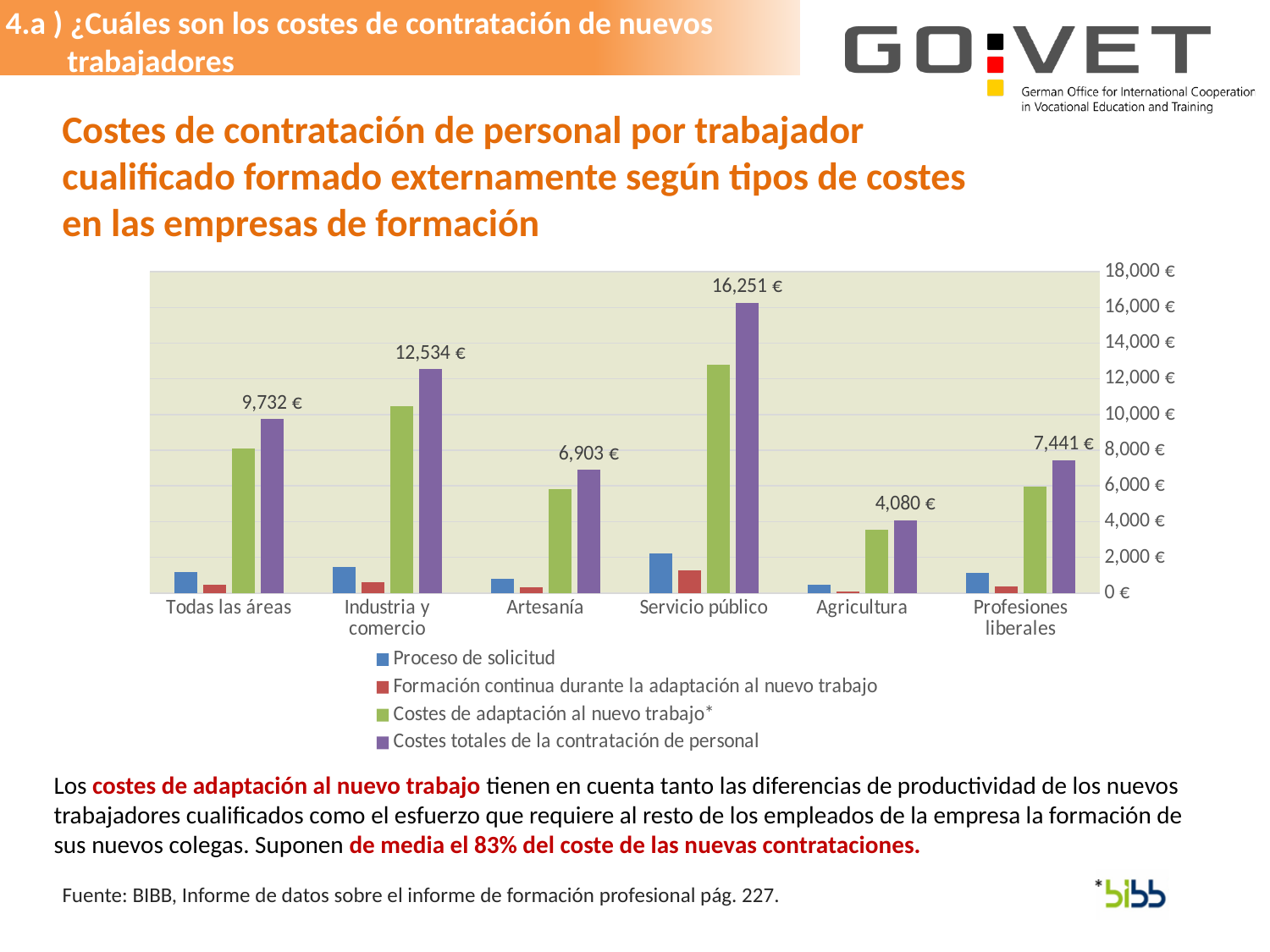
Is the value of 'Costes de adaptación al nuevo trabajo*' for Servicio público greater or less than 12,000 €? greater What is the value of 'Costes totales de la contratación de personal' for Servicio público? 16,251 € What is the difference between the 'Costes totales de la contratación de personal' for Servicio público and Agricultura? 12,171 € What is the value of 'Costes totales de la contratación de personal' for Agricultura? 4,080 € How many series does the legend list? 4 How many categories are shown on the x axis? 6 Which category has the highest 'Costes totales de la contratación de personal'? Servicio público What kind of chart is shown on the slide? Bar chart Which is larger, the 'Costes totales de la contratación de personal' for Artesanía or for Profesiones liberales? Profesiones liberales Which category has the lowest 'Costes totales de la contratación de personal'? Agricultura What is the value of 'Costes totales de la contratación de personal' for Todas las áreas? 9,732 € What is the value of 'Costes totales de la contratación de personal' for Industria y comercio? 12,534 €